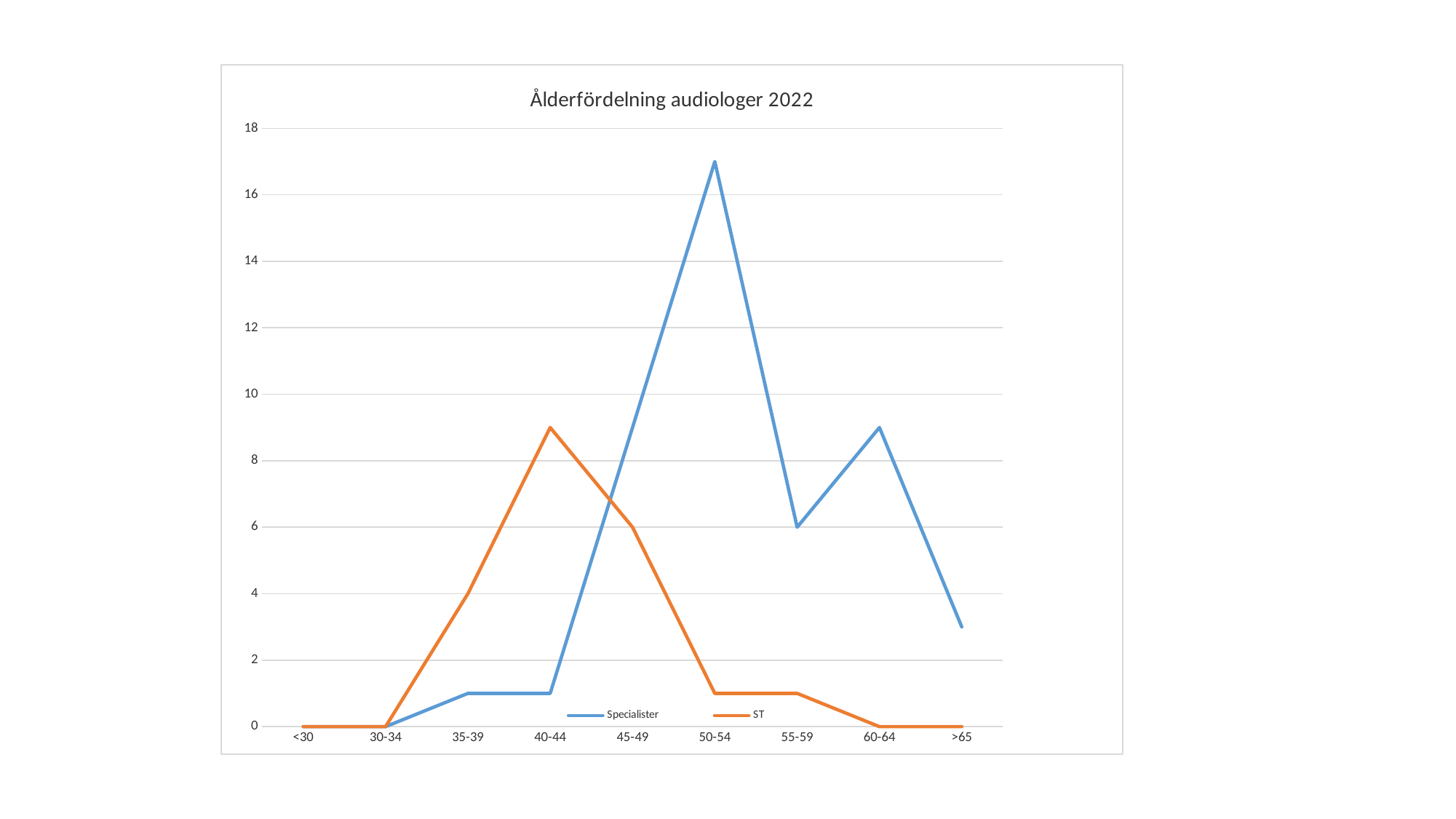
In which age group does the Specialister series reach its highest value? 50-54 What is the value for Specialister in the 55-59 age group? 6 What is the value for ST in the 45-49 age group? 6 Does the Specialister series rise or fall from the 50-54 age group to the 55-59 age group? fall What is the value for ST in the 60-64 age group? 0 How many series does the legend list? 2 In which age group does the ST series reach its highest value? 40-44 Is the value for Specialister in the 50-54 age group greater or less than 16? greater How many age categories are shown on the x axis? 9 Which series has the larger value in the 40-44 age group, Specialister or ST? ST What kind of chart is shown on the slide? line chart What is the title of the chart? Ålderfördelning audiologer 2022